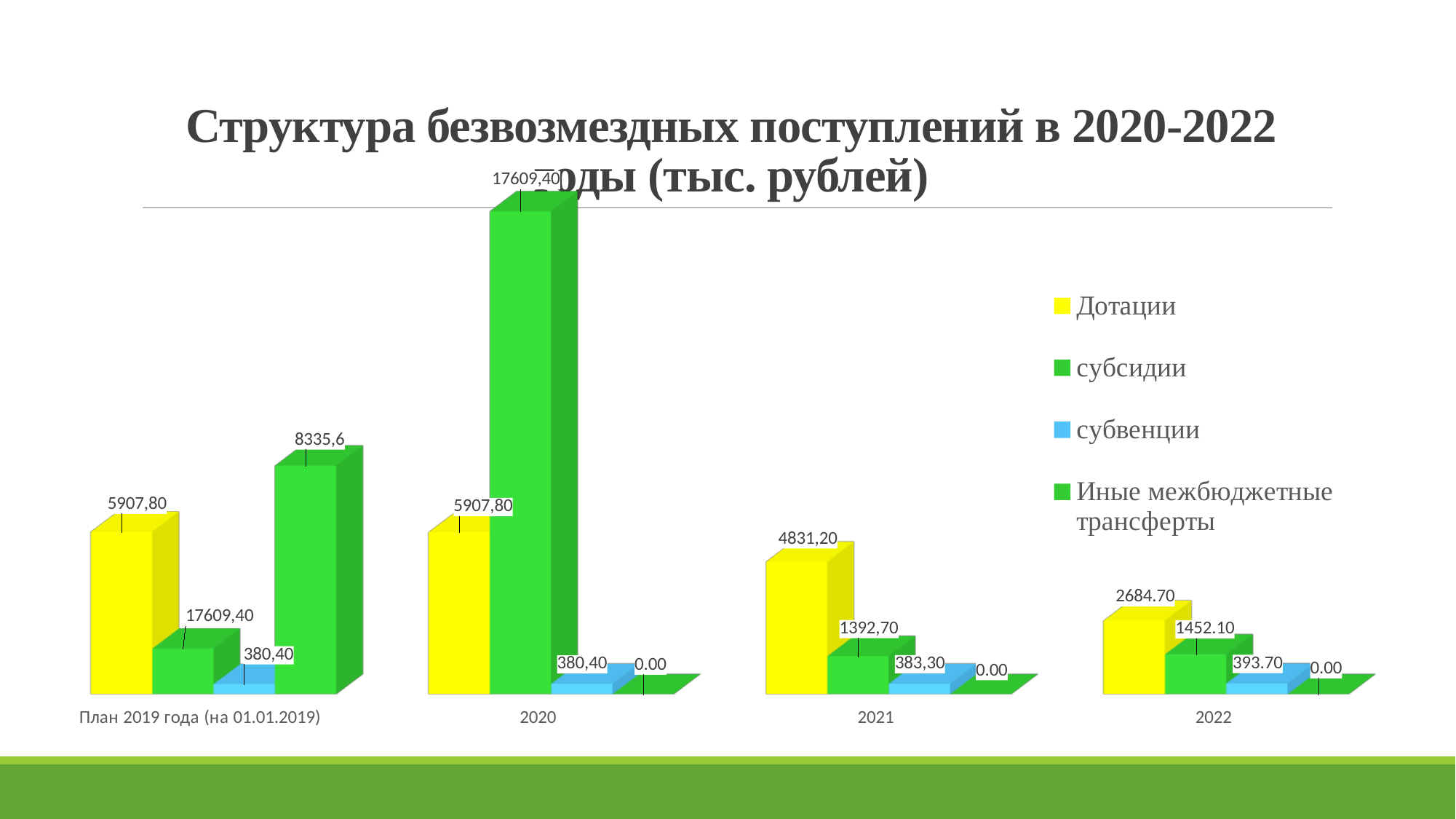
Which year has the larger value for субвенции, 2021 or 2022? 2022 What is the value of субсидии for 2020? 17609,40 In 2022, what is the difference between Дотации and субсидии? 1232.60 Do the values for Дотации rise or fall from 2020 to 2022? fall How many categories are shown on the x axis? 4 What is the value of Иные межбюджетные трансферты for План 2019 года (на 01.01.2019)? 8335,6 Which category has the lowest value for Дотации? 2022 Which series has the highest value in 2020? субсидии What is the value of Иные межбюджетные трансферты for 2021? 0.00 What is the value of Дотации for 2021? 4831,20 What is the value of субвенции for 2022? 393.70 How many series does the legend list? 4